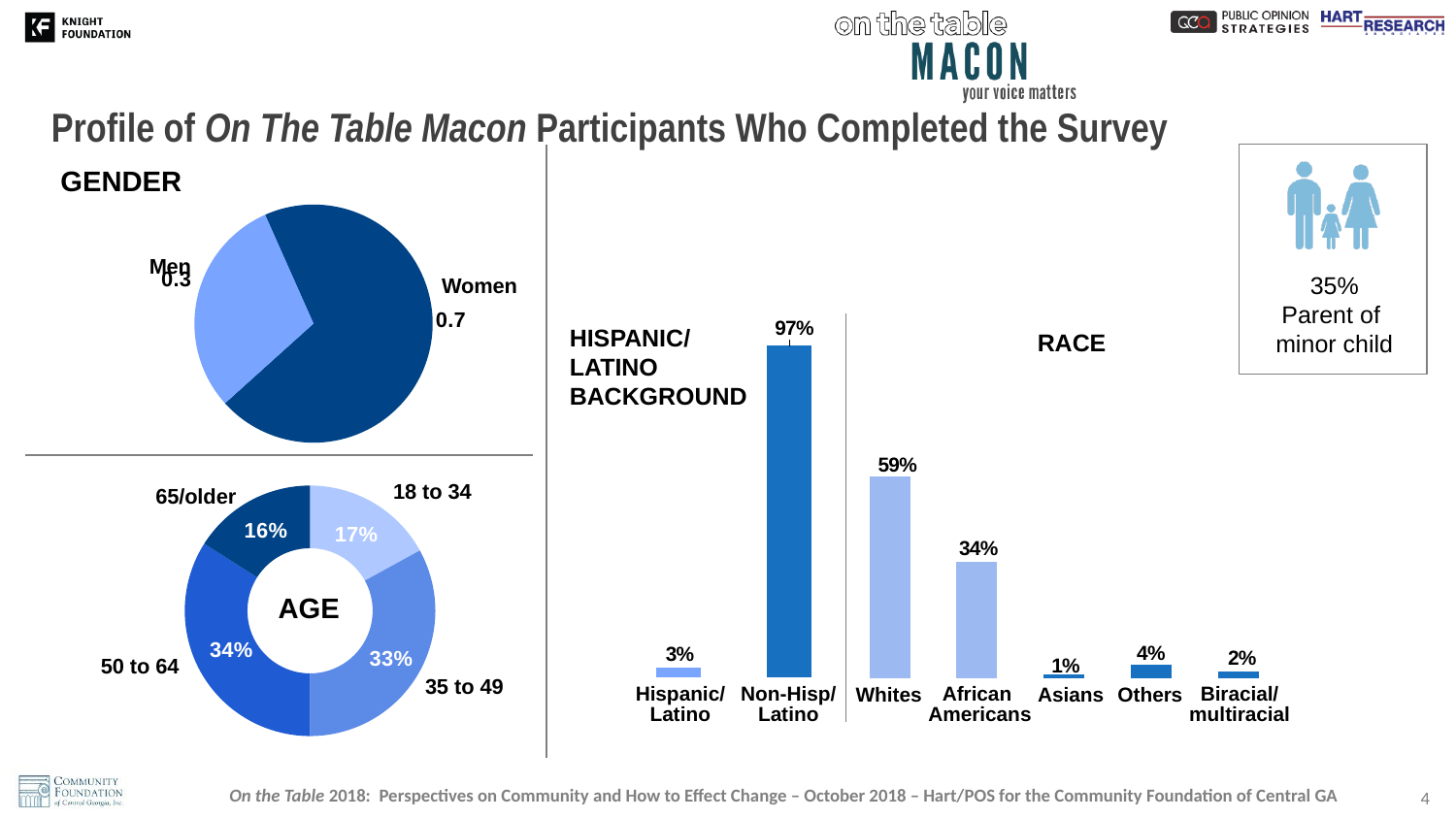
In the AGE chart, which age group has the largest share? 50 to 64 In the AGE chart, what percentage is shown for 18 to 34? 17% What kind of chart is the GENDER chart? pie chart In the RACE bar chart, which category has the lowest value? Asians In the AGE chart, what percentage is shown for 65/older? 16% In the GENDER pie chart, what value is shown for Men? 0.3 In the AGE chart, how many age groups are shown? 4 In the AGE chart, what is the difference between the 35 to 49 share and the 18 to 34 share? 16% In the RACE bar chart, what percentage is shown for African Americans? 34% In the RACE bar chart, what is the difference between Whites and African Americans? 25% In the bar chart, what percentage of participants are Non-Hisp/Latino? 97% In the GENDER pie chart, what value is shown for Women? 0.7